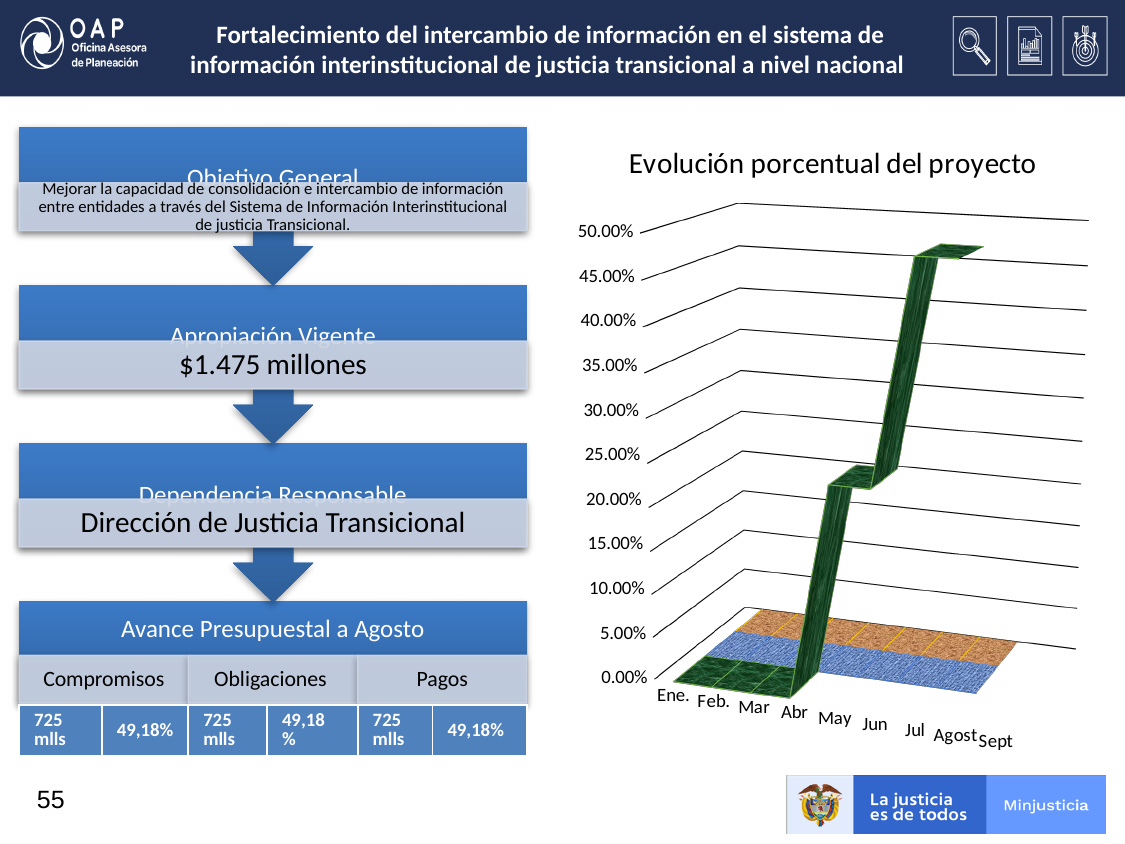
Do the values in the chart generally rise or fall from Ene. to Sept? rise Which has the larger value, May or Jul? Jul Is the value for Ene. greater or less than 5.00%? less What kind of chart is shown on the slide? line chart What is the title of the chart on the slide? Evolución porcentual del proyecto How many months are shown along the x axis of the chart? 9 What is the highest value shown on the vertical axis of the chart? 50.00% Is the value for Jul greater or less than 30.00%? greater Is the value for Abr greater or less than 10.00%? less